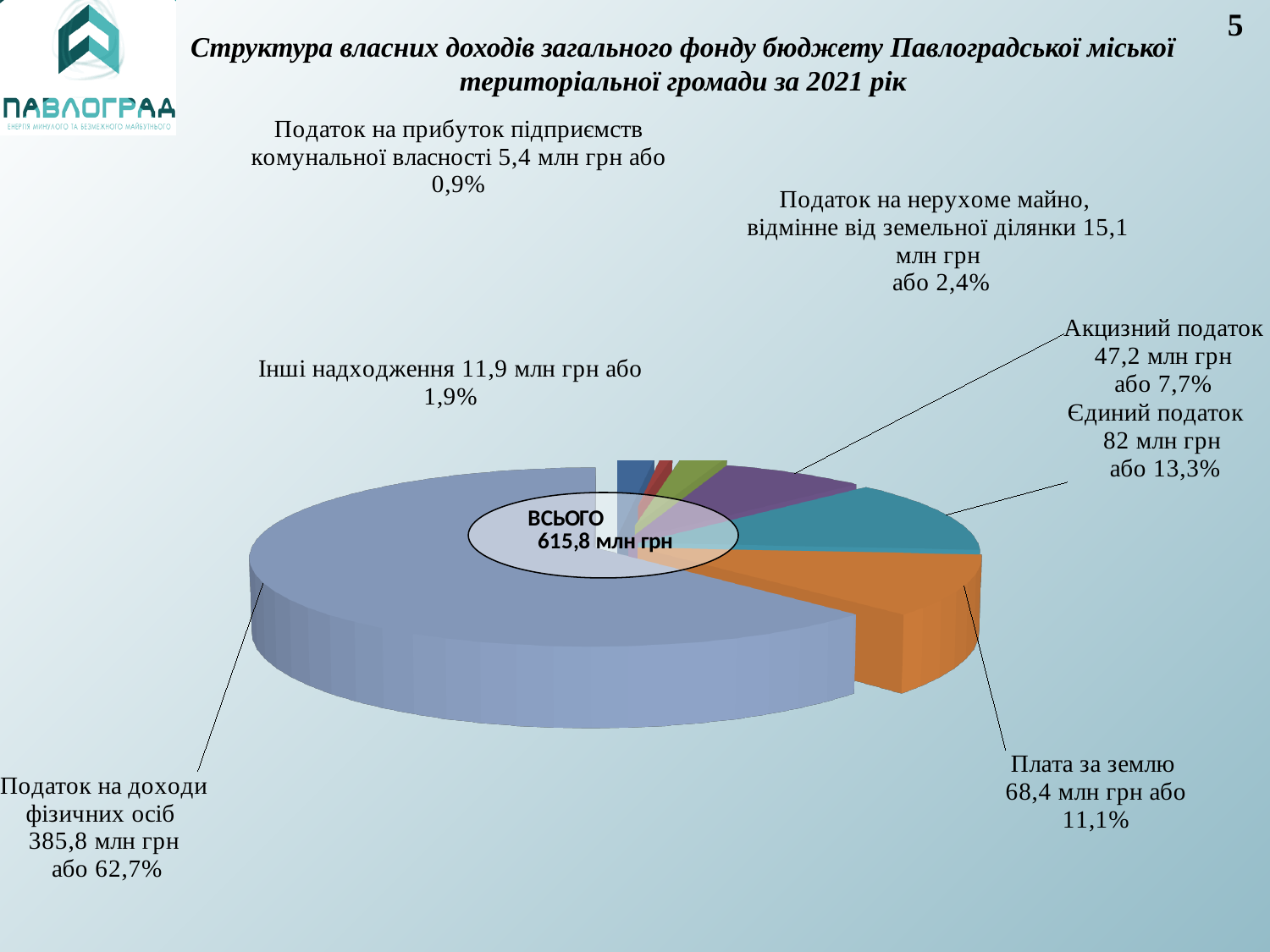
Which category has the smallest slice of the pie? Податок на прибуток підприємств комунальної власності Which category has the largest slice of the pie? Податок на доходи фізичних осіб Which is larger: Єдиний податок or Плата за землю? Єдиний податок How many categories does the pie chart show? 7 What is the value for Плата за землю? 68,4 млн грн What is the value for Податок на доходи фізичних осіб? 385,8 млн грн What is the value for Податок на нерухоме майно, відмінне від земельної ділянки? 15,1 млн грн What is the difference in млн грн between Єдиний податок and Акцизний податок? 34,8 млн грн What share of the pie does Єдиний податок represent? 13,3% What total value is shown in the centre of the pie chart? 615,8 млн грн What share of the pie does Акцизний податок represent? 7,7% What kind of chart is shown on the slide? pie chart